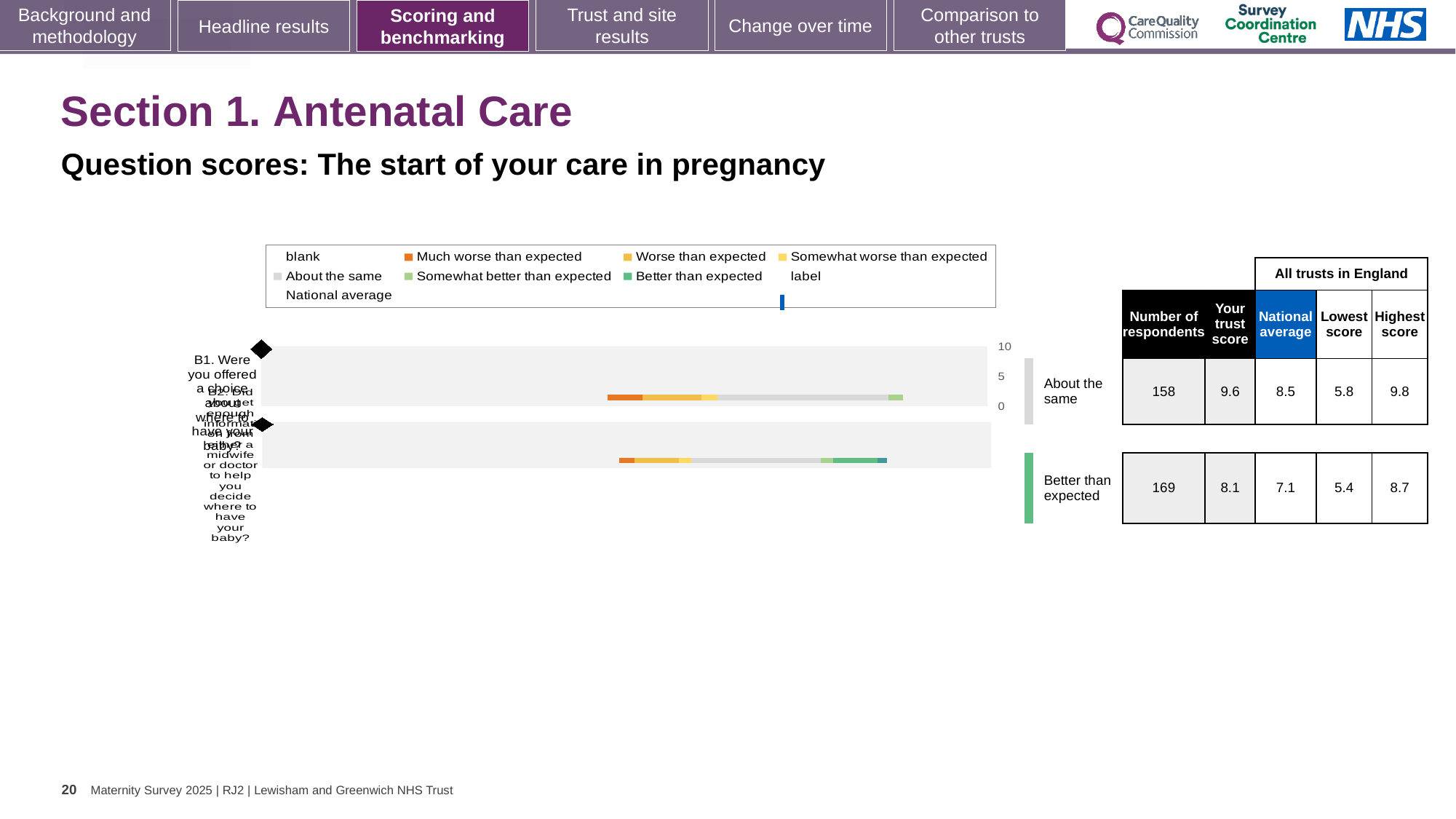
What is the highest score across all trusts in England for question B1? 9.8 What colour does the legend use for 'Much worse than expected'? orange How many questions (bars) are plotted in the chart? 2 What is the 'Your trust score' for question B1 (Were you offered a choice about where to have your baby?)? 9.6 What is the difference between the trust score and the national average for question B2? 1.0 What is the 'Your trust score' for question B2 (Did you get enough information from a midwife or doctor to help you decide where to have your baby?)? 8.1 What is the number of respondents for question B2? 169 What benchmark category is question B2 rated as? Better than expected What is the national average score for question B1? 8.5 Which question has the higher trust score, B1 or B2? B1 What colour does the legend use for 'Better than expected'? green What kind of chart is shown on the slide? bar chart